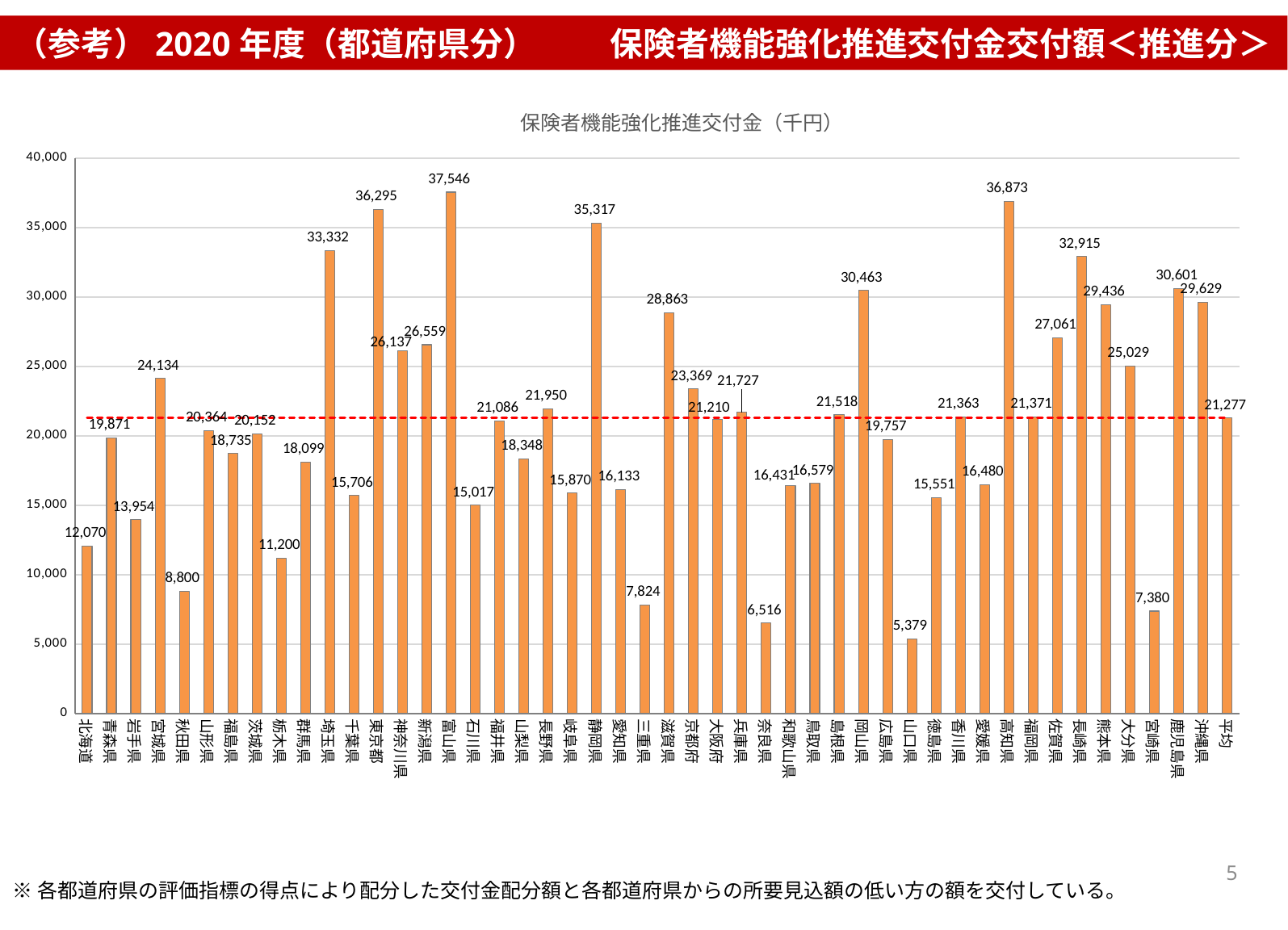
How many bars are plotted in the chart? 48 What is the difference between the values for 富山県 and 山口県? 32,167 What is the title of the chart? 保険者機能強化推進交付金（千円） What is the value for 北海道? 12,070 Which prefecture has the lowest value? 山口県 What is the value for 富山県? 37,546 Is the value for 秋田県 greater or less than 10,000? less What is the value for 平均? 21,277 Which is larger, the value for 高知県 or the value for 静岡県? 高知県 What is the difference between the values for 東京都 and 北海道? 24,225 Which prefecture has the highest value? 富山県 What kind of chart is shown on the slide? bar chart